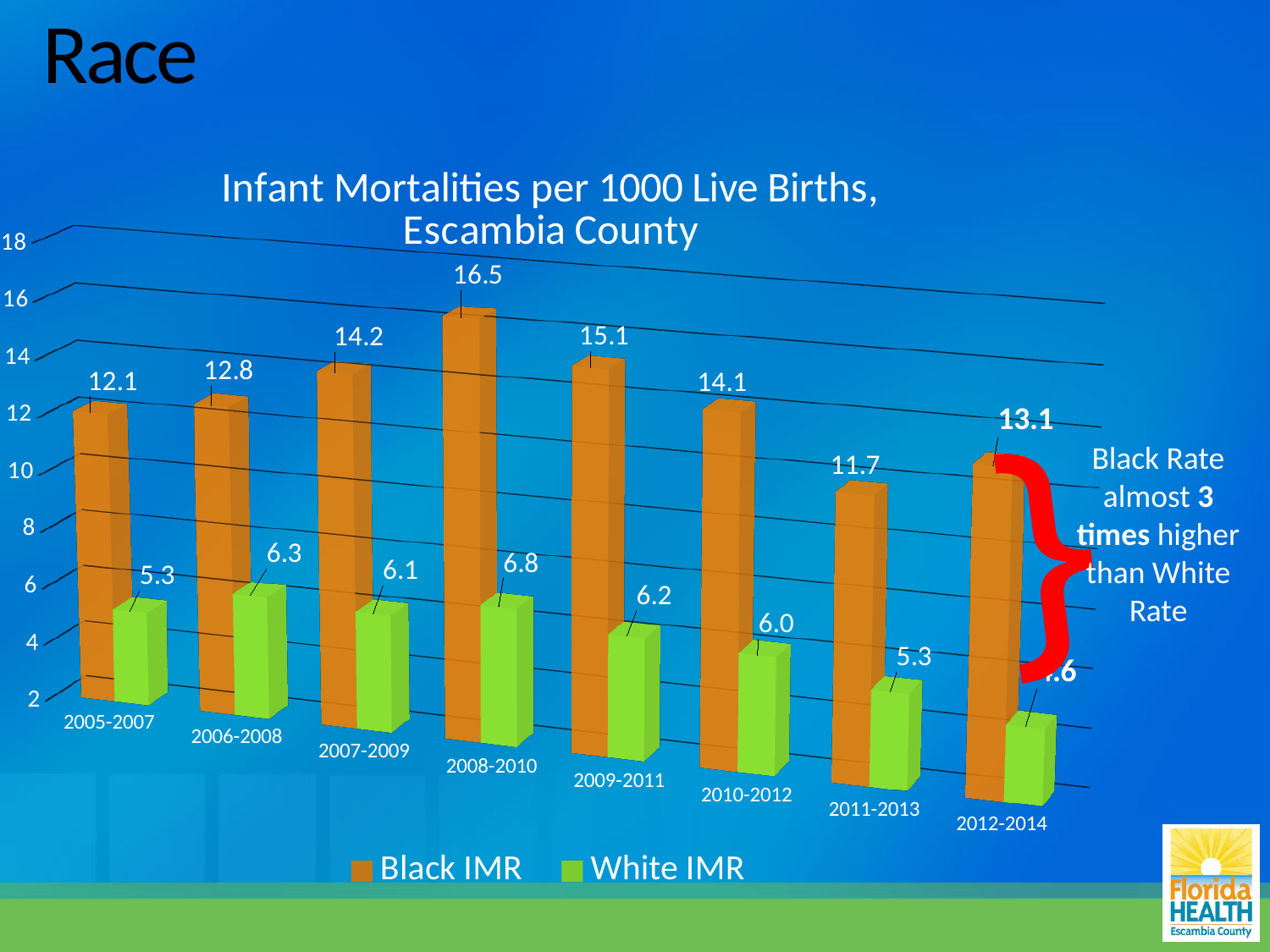
What is the difference between the Black IMR and the White IMR for 2008-2010? 9.7 Which period has the lowest Black IMR? 2011-2013 Which period has the highest White IMR? 2008-2010 How many series does the legend list? 2 What is the Black IMR value for 2008-2010? 16.5 What is the Black IMR value for 2011-2013? 11.7 What is the White IMR value for 2006-2008? 6.3 What is the title of the chart? Infant Mortalities per 1000 Live Births, Escambia County What kind of chart is shown on the slide? Bar chart How many time periods are shown on the x axis? 8 Which is larger, the Black IMR for 2007-2009 or the Black IMR for 2009-2011? 2009-2011 Which period has the highest Black IMR? 2008-2010